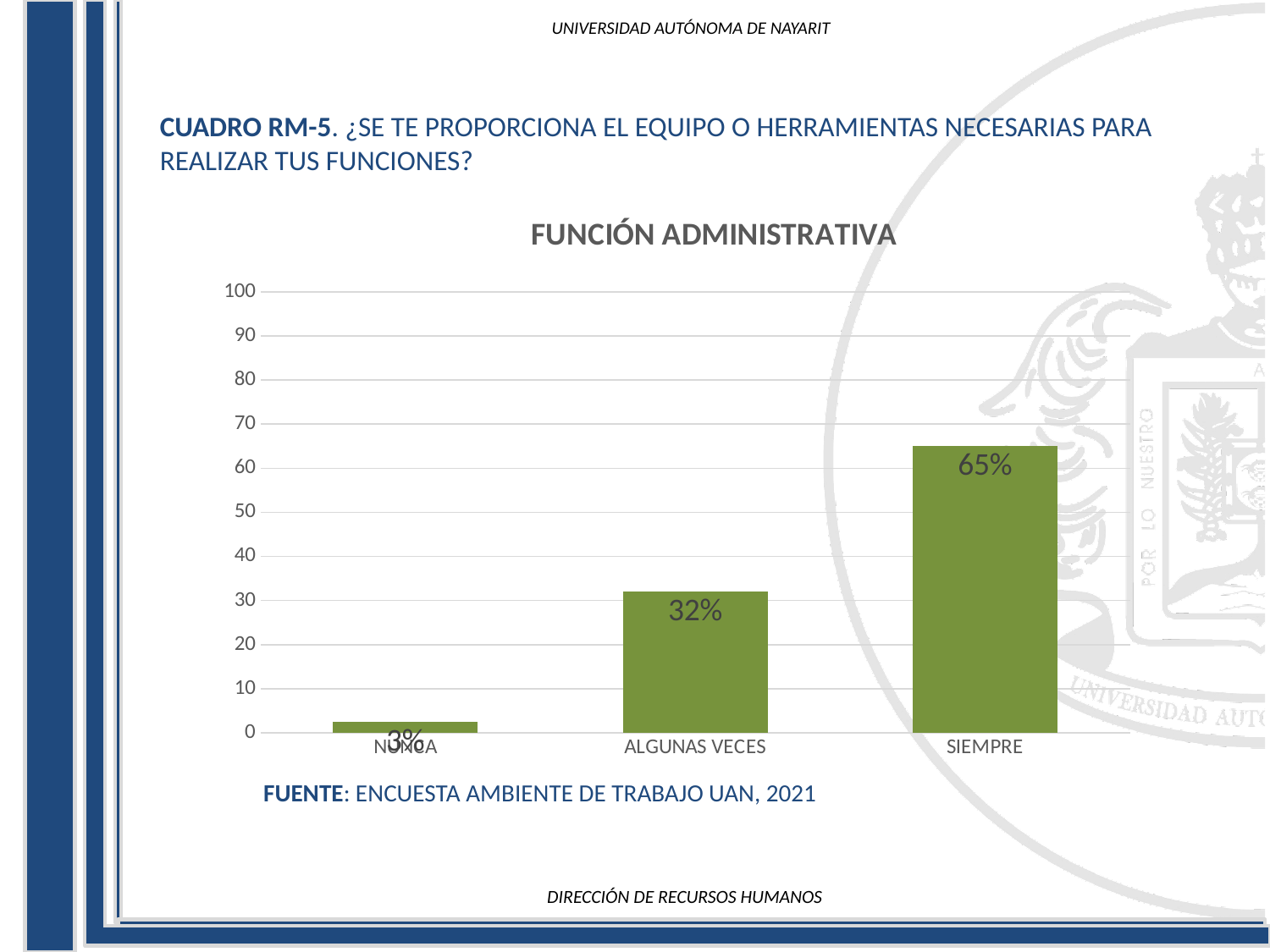
Which category has the lowest value? NUNCA Which category has the highest value? SIEMPRE What is the difference between the values for SIEMPRE and ALGUNAS VECES? 33% Is the value for SIEMPRE greater or less than 60? greater What is the title of the chart? FUNCIÓN ADMINISTRATIVA What is the value for NUNCA? 3% What is the value for SIEMPRE? 65% What kind of chart is shown on the slide? bar chart What is the difference between the values for ALGUNAS VECES and NUNCA? 29% How many categories are shown on the x axis? 3 What is the value for ALGUNAS VECES? 32% Which is larger, the value for ALGUNAS VECES or the value for SIEMPRE? SIEMPRE